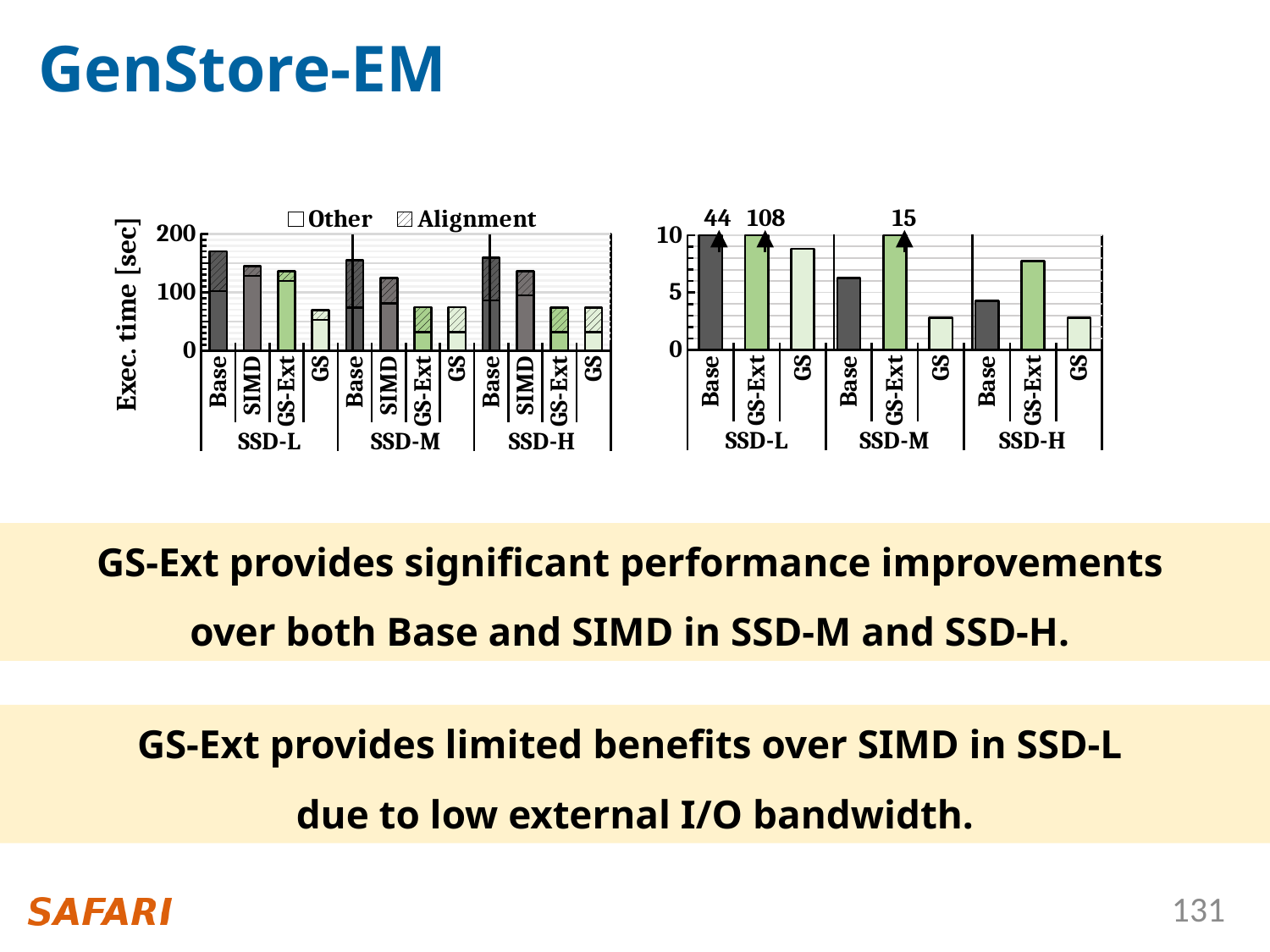
On the right chart, what is the value for Base in SSD-L? 44 On the right chart, what is the difference between the GS-Ext and Base values in SSD-L? 64 On the right chart, is the value for GS in SSD-M greater or less than 5? less On the right chart, what is the value for GS-Ext in SSD-M? 15 On the left chart, what kind of chart is shown? Stacked bar chart On the right chart, what is the value for GS-Ext in SSD-L? 108 On the left chart, which configuration has the lowest execution time in the SSD-M group? GS-Ext and GS (tied) On the left chart, is the total execution time for Base in SSD-L greater or less than 100? greater On the left chart, how many series does the legend list? 2 On the left chart, what are the two legend entries? Other and Alignment On the left chart, is the total execution time for GS in SSD-L greater or less than 100? less On the left chart, how many bars are plotted in total across the three SSD groups? 12